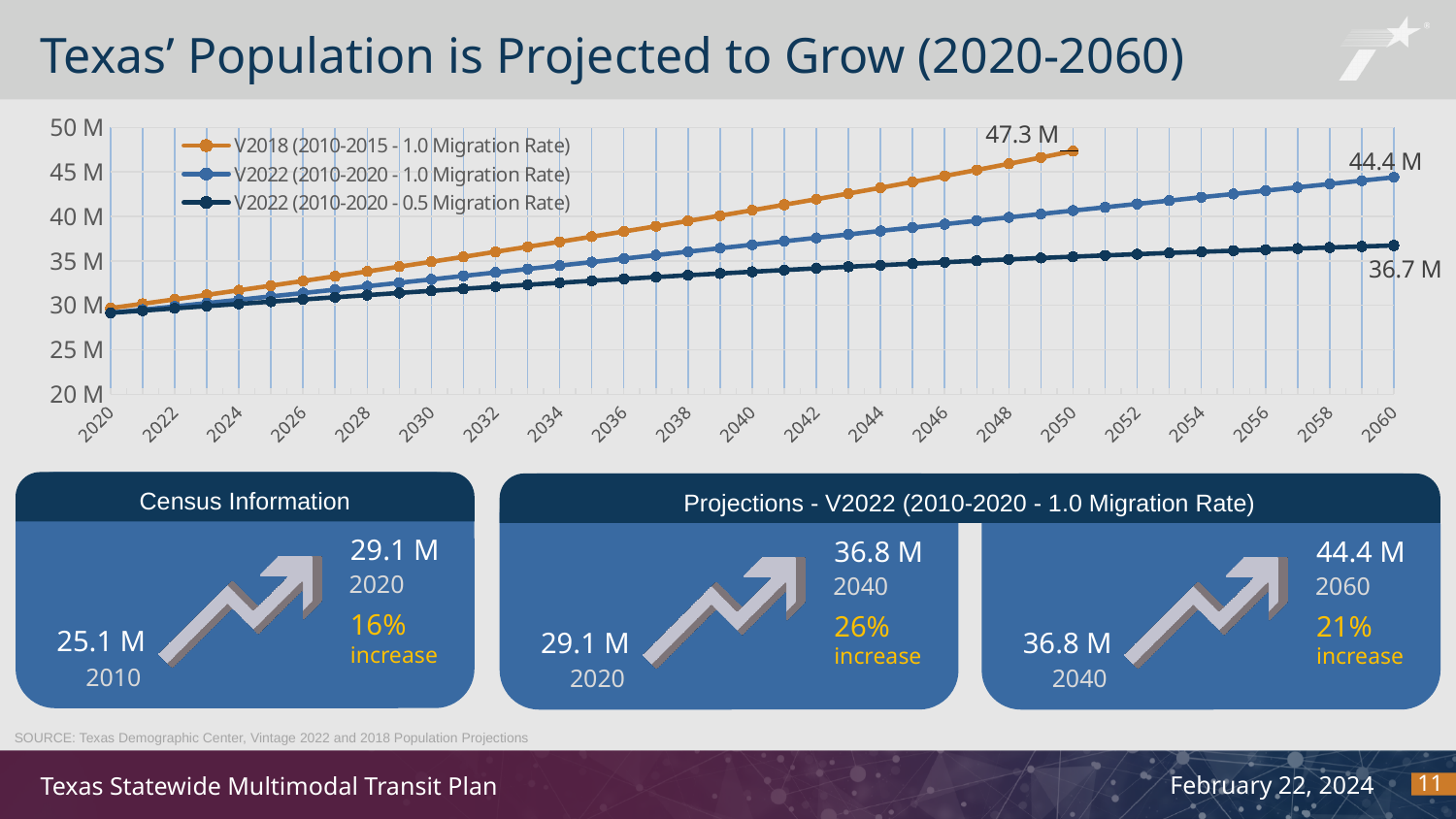
What is the final labelled value of the V2018 (2010-2015 - 1.0 Migration Rate) series, in 2050? 47.3 M What kind of chart is shown on the slide? line chart Is the value for the V2018 (2010-2015 - 1.0 Migration Rate) series in 2044 greater or less than 40 M? greater What is the projected population for the V2022 (2010-2020 - 0.5 Migration Rate) series in 2060? 36.7 M Which series reaches the highest labelled value on the chart? V2018 (2010-2015 - 1.0 Migration Rate) Is the value for the V2022 (2010-2020 - 0.5 Migration Rate) series in 2040 greater or less than 35 M? less In 2060, which series is higher: V2022 (2010-2020 - 1.0 Migration Rate) or V2022 (2010-2020 - 0.5 Migration Rate)? V2022 (2010-2020 - 1.0 Migration Rate) What is the projected population for the V2022 (2010-2020 - 1.0 Migration Rate) series in 2060? 44.4 M What is the difference between the 2060 values of the V2022 1.0 Migration Rate series and the V2022 0.5 Migration Rate series? 7.7 M How many series does the chart legend list? 3 What is the title of the slide containing the chart? Texas' Population is Projected to Grow (2020-2060) Do the values of the V2022 (2010-2020 - 1.0 Migration Rate) series rise or fall from 2020 to 2060? rise